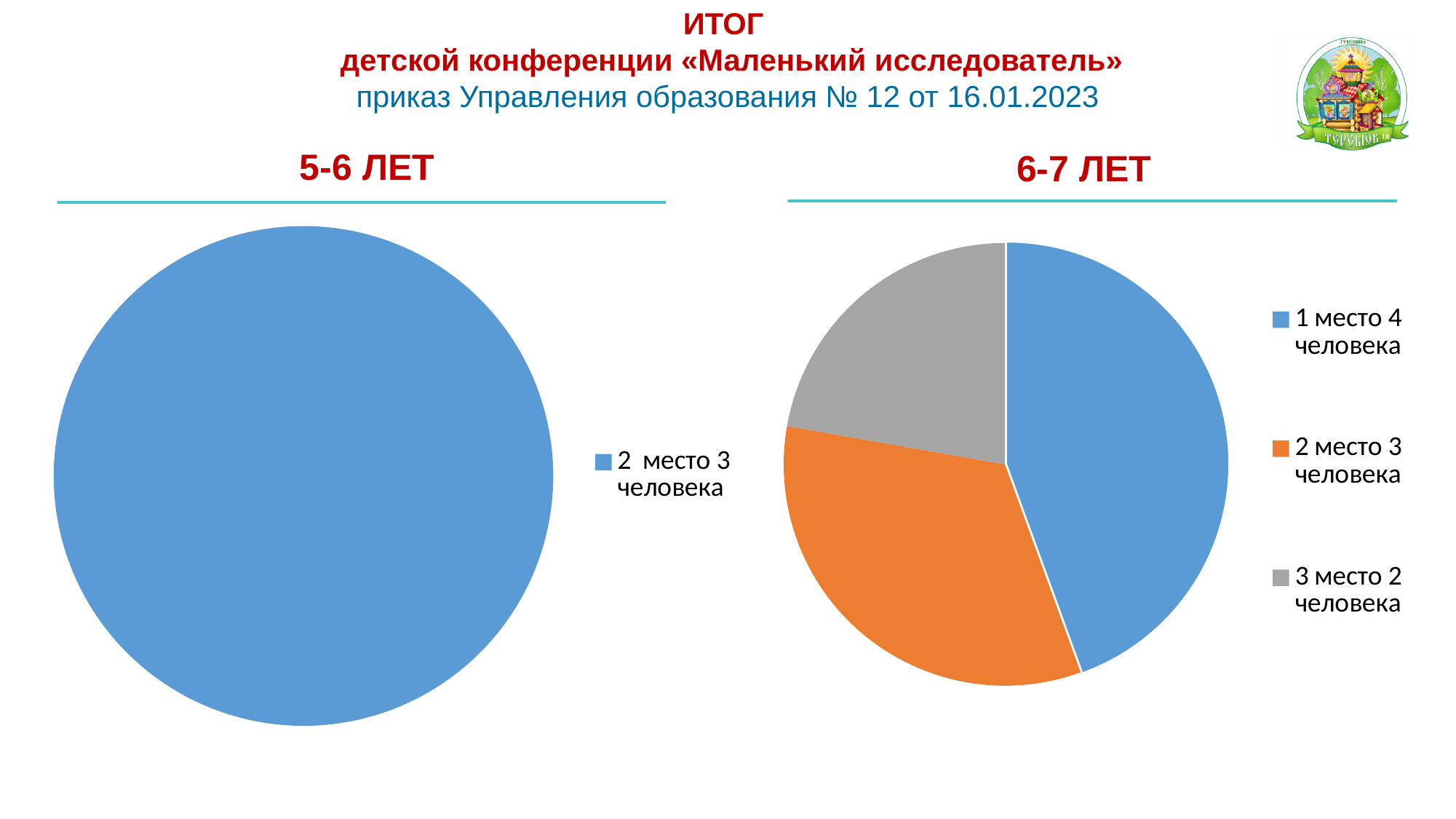
In the "6-7 ЛЕТ" chart, which place has the largest slice? 1 место In the "5-6 ЛЕТ" chart, how many people are listed for 2 место? 3 человека In the "5-6 ЛЕТ" chart, how many entries does the legend list? 1 In the "6-7 ЛЕТ" chart, how many entries does the legend list? 3 In the "6-7 ЛЕТ" chart, how many people are listed for 3 место? 2 человека In the "6-7 ЛЕТ" chart, what colour is the slice for 2 место? Orange What kind of chart is shown under the heading "6-7 ЛЕТ"? Pie chart What kind of chart is shown under the heading "5-6 ЛЕТ"? Pie chart In the "6-7 ЛЕТ" chart, how many more people are in 1 место than in 3 место? 2 In the "6-7 ЛЕТ" chart, how many slices does the pie have? 3 In the "6-7 ЛЕТ" chart, how many people are listed for 1 место? 4 человека In the "6-7 ЛЕТ" chart, which place has the smallest slice? 3 место